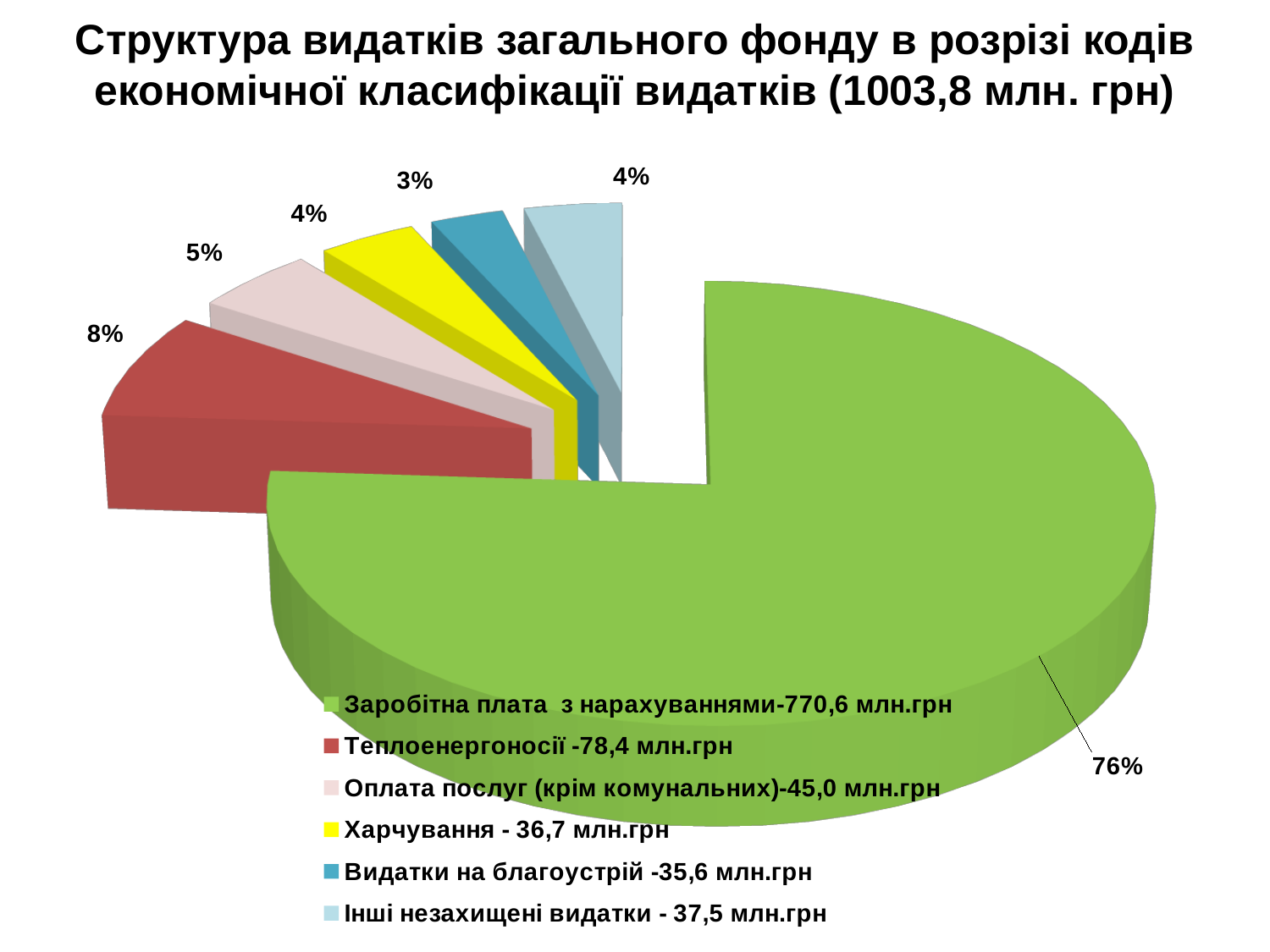
What share of the pie does Теплоенергоносії take? 8% According to the legend, what is the amount for Інші незахищені видатки? 37,5 млн.грн According to the legend, what is the amount for Харчування? 36,7 млн.грн What share of the pie does Заробітна плата з нарахуваннями take? 76% What share of the pie does Оплата послуг (крім комунальних) take? 5% What kind of chart is shown on the slide? pie chart What is the difference between the amounts for Теплоенергоносії and Оплата послуг (крім комунальних) shown in the legend? 33,4 млн.грн What total amount is given in the chart title? 1003,8 млн. грн How many slices does the pie chart have? 6 Which category has the largest slice of the pie? Заробітна плата з нарахуваннями Which category has the smallest slice of the pie? Видатки на благоустрій Which is larger: the amount for Теплоенергоносії or the amount for Видатки на благоустрій? Теплоенергоносії